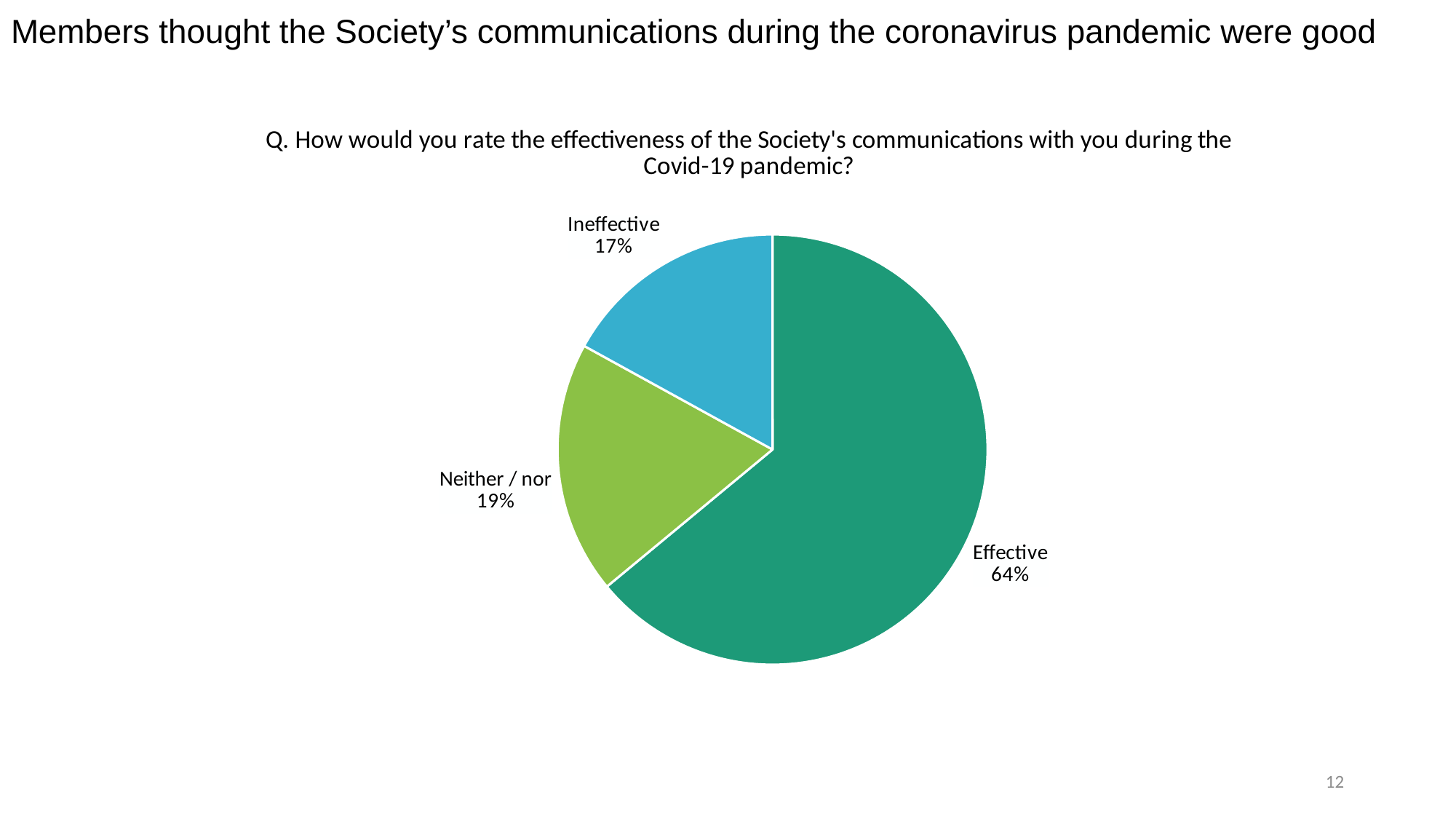
Which response has the largest share of the pie? Effective Which response has the smallest share of the pie? Ineffective What is the difference in percentage points between Neither / nor and Ineffective? 2 How many slices does the pie chart have? 3 What colour is the Ineffective slice? blue What percentage of members rated the Society's communications as Effective? 64% What is the difference in percentage points between Effective and Ineffective? 47 Which is larger, the share for Neither / nor or the share for Ineffective? Neither / nor What percentage of members rated the Society's communications as Ineffective? 17% What kind of chart is shown on the slide? pie chart What share of the pie does the Effective slice represent? 64% What percentage of members answered Neither / nor? 19%